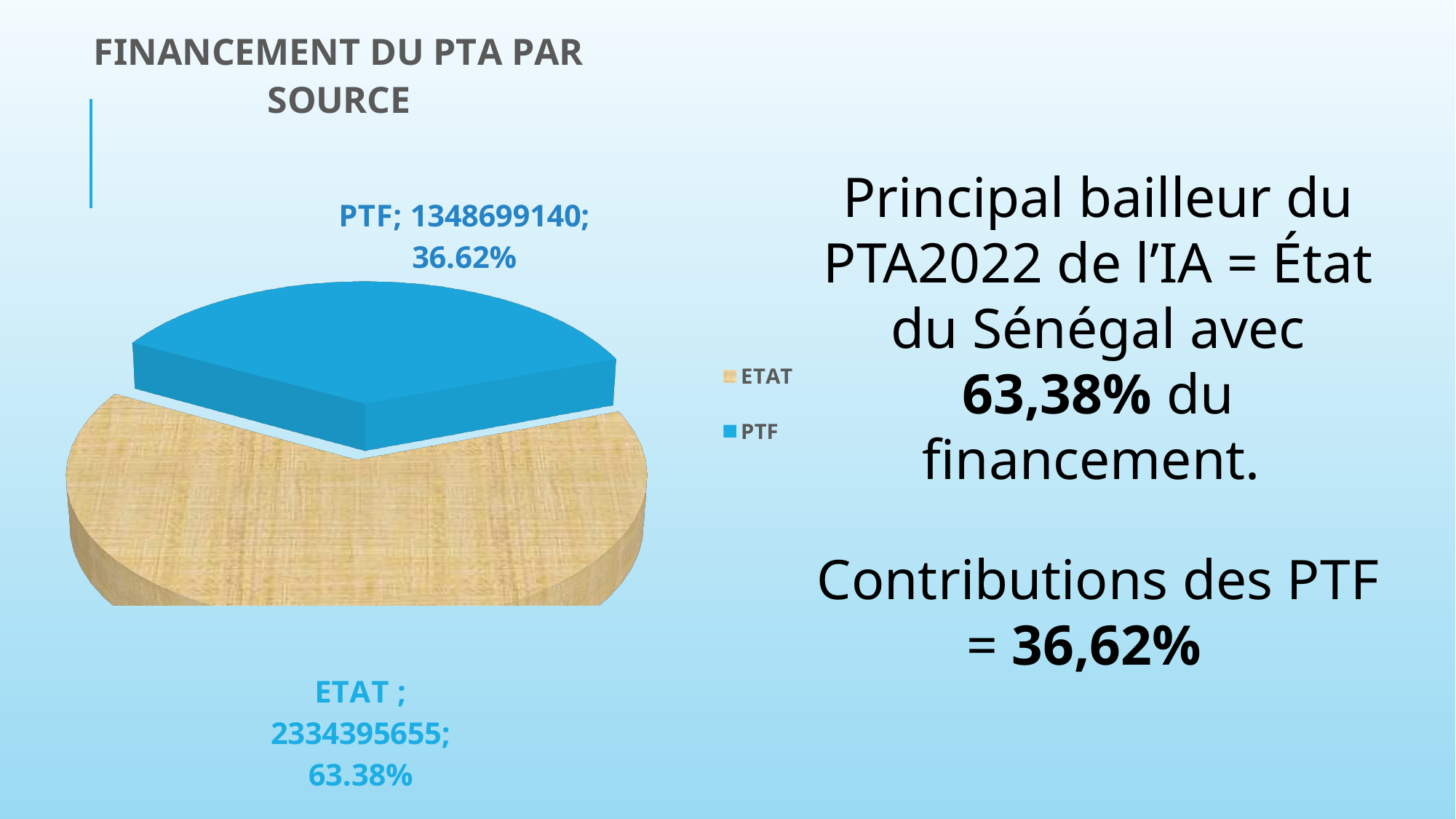
Which source has the largest slice of the pie? ETAT What is the value for PTF in the pie chart? 1348699140 What type of chart is shown on the slide? Pie chart Which is larger, the value for ETAT or the value for PTF? ETAT What is the value for ETAT in the pie chart? 2334395655 What is the title of the chart? FINANCEMENT DU PTA PAR SOURCE How many slices does the pie chart have? 2 Which source has the smallest slice of the pie? PTF What share of the pie does ETAT represent? 63.38% What colour is the PTF slice in the pie chart? Blue What share of the pie does PTF represent? 36.62% What is the difference between the ETAT value and the PTF value? 985696515